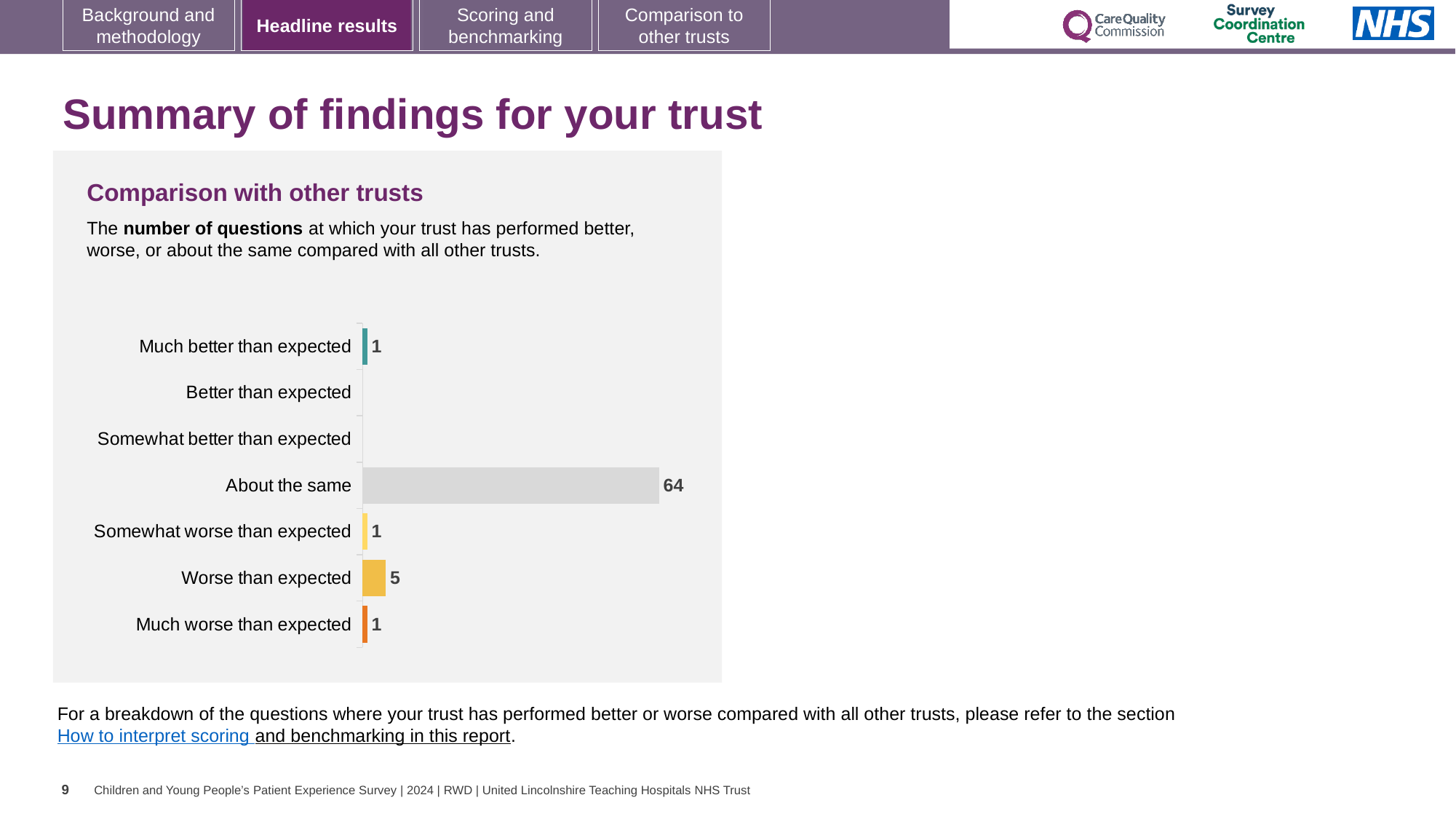
What is the value for 'Somewhat worse than expected'? 1 What is the difference between the values for 'Worse than expected' and 'Much worse than expected'? 4 What type of chart is shown on the slide? bar chart How many questions were rated 'About the same'? 64 What is the value for 'Much worse than expected'? 1 What is the difference between the values for 'About the same' and 'Worse than expected'? 59 Which is larger, the value for 'Worse than expected' or the value for 'Somewhat worse than expected'? Worse than expected What is the title of the chart? Comparison with other trusts What is the value for 'Worse than expected'? 5 What is the value for 'Much better than expected'? 1 Which category has the highest value? About the same How many categories are shown on the chart? 7